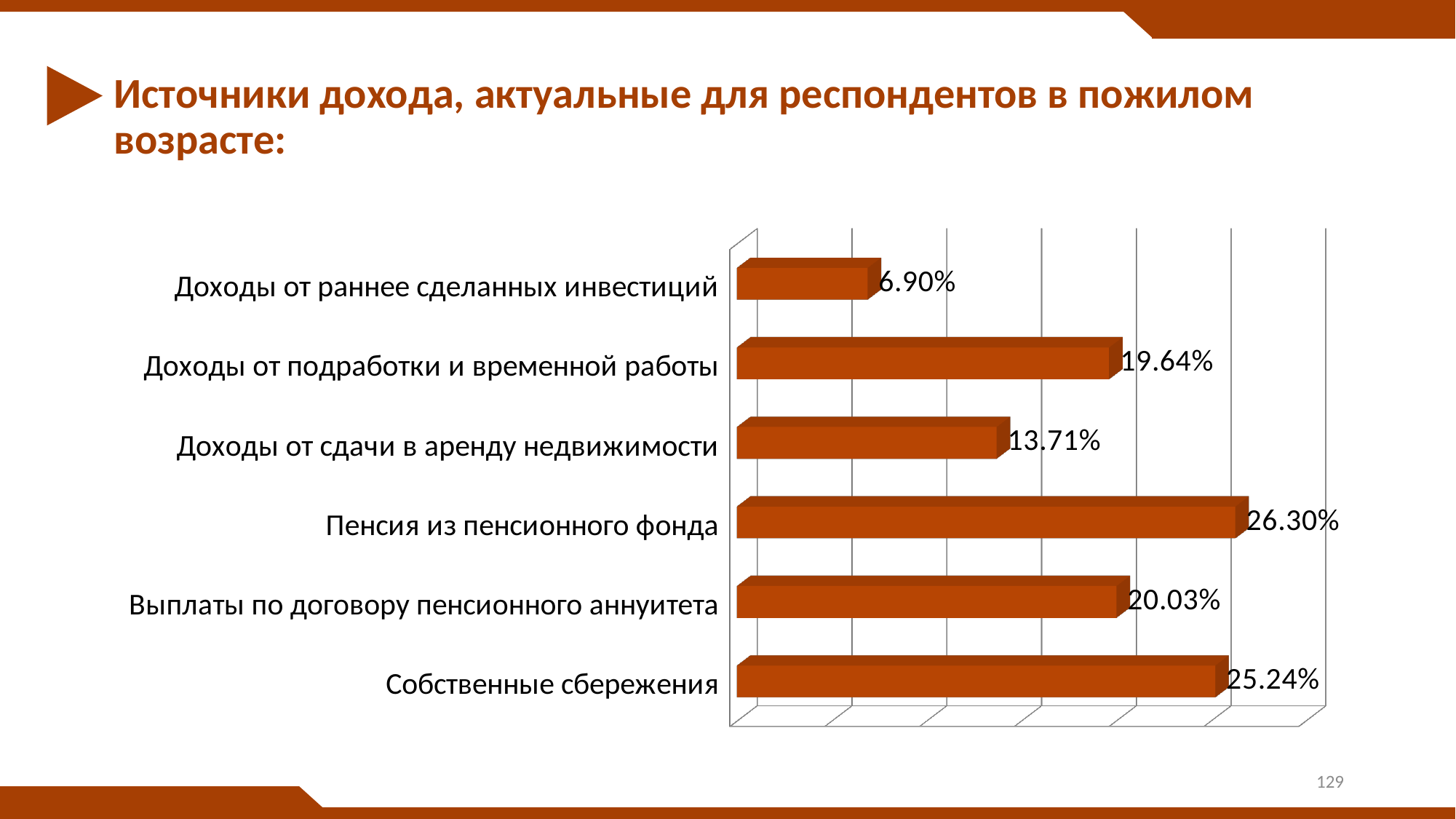
Which income source has the highest value? Пенсия из пенсионного фонда What is the value for «Собственные сбережения»? 25.24% What is the value for «Доходы от сдачи в аренду недвижимости»? 13.71% How many income sources are shown in the chart? 6 What kind of chart is shown on the slide? Bar chart What is the value for «Выплаты по договору пенсионного аннуитета»? 20.03% What is the difference between «Доходы от подработки и временной работы» and «Доходы от сдачи в аренду недвижимости»? 5.93% Which is larger: «Доходы от подработки и временной работы» or «Доходы от сдачи в аренду недвижимости»? Доходы от подработки и временной работы What is the value for «Пенсия из пенсионного фонда»? 26.30% What is the difference between «Пенсия из пенсионного фонда» and «Собственные сбережения»? 1.06% What is the title of the slide? Источники дохода, актуальные для респондентов в пожилом возрасте: Which income source has the lowest value? Доходы от раннее сделанных инвестиций